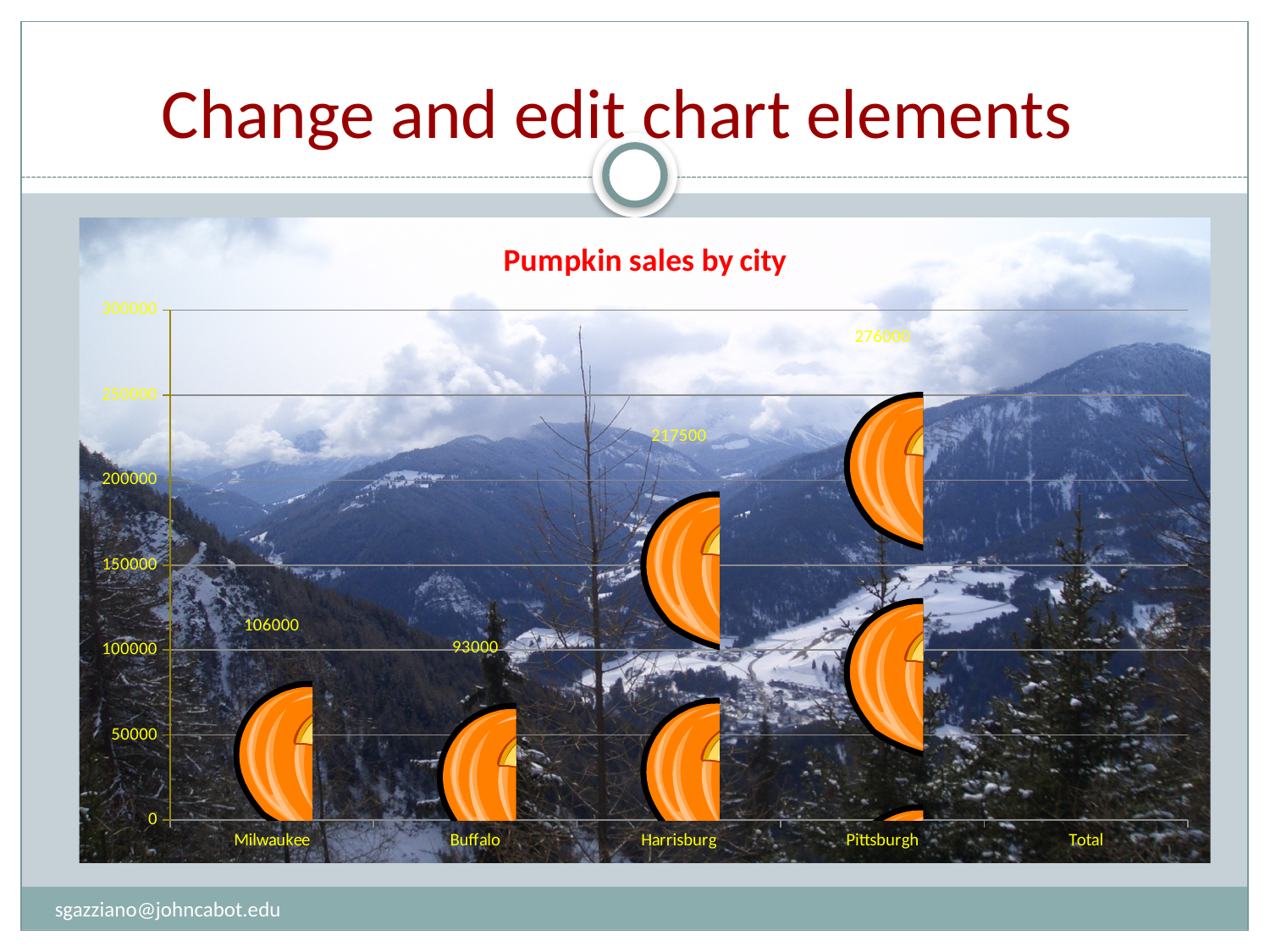
What is the pumpkin sales value for Pittsburgh? 276000 Which has higher pumpkin sales, Harrisburg or Milwaukee? Harrisburg What is the pumpkin sales value for Harrisburg? 217500 What type of chart is shown on the slide? bar chart What is the pumpkin sales value for Milwaukee? 106000 What is the title of the chart? Pumpkin sales by city Which city has the highest pumpkin sales? Pittsburgh How many category labels are shown on the x axis? 5 Is the value for Harrisburg greater or less than 200000? greater What is the pumpkin sales value for Buffalo? 93000 What is the difference between the pumpkin sales of Pittsburgh and Harrisburg? 58500 Which city has the lowest labelled pumpkin sales value? Buffalo